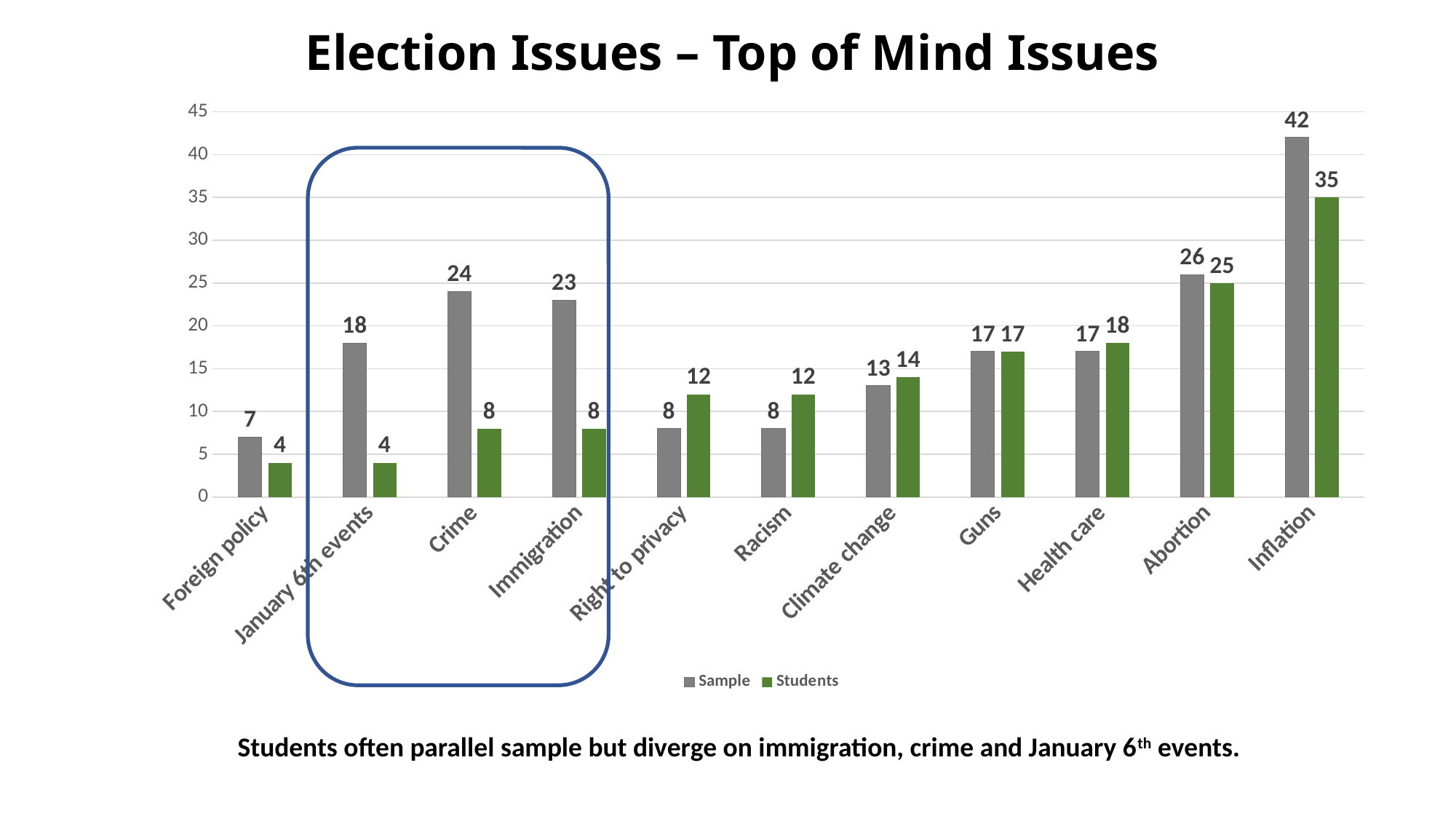
What kind of chart is shown on the slide? Bar chart Which is larger for Right to privacy, the Sample value or the Students value? Students Which category has the highest Sample value? Inflation What is the difference between the Sample and Students values for Immigration? 15 What is the Students value for Inflation? 35 What is the title of the chart? Election Issues – Top of Mind Issues Is the Sample value for Abortion greater or less than 20? greater What is the Sample value for Crime? 24 How many series does the legend list? 2 What is the Students value for January 6th events? 4 How many categories are shown on the x axis? 11 Which category has the lowest Sample value? Foreign policy